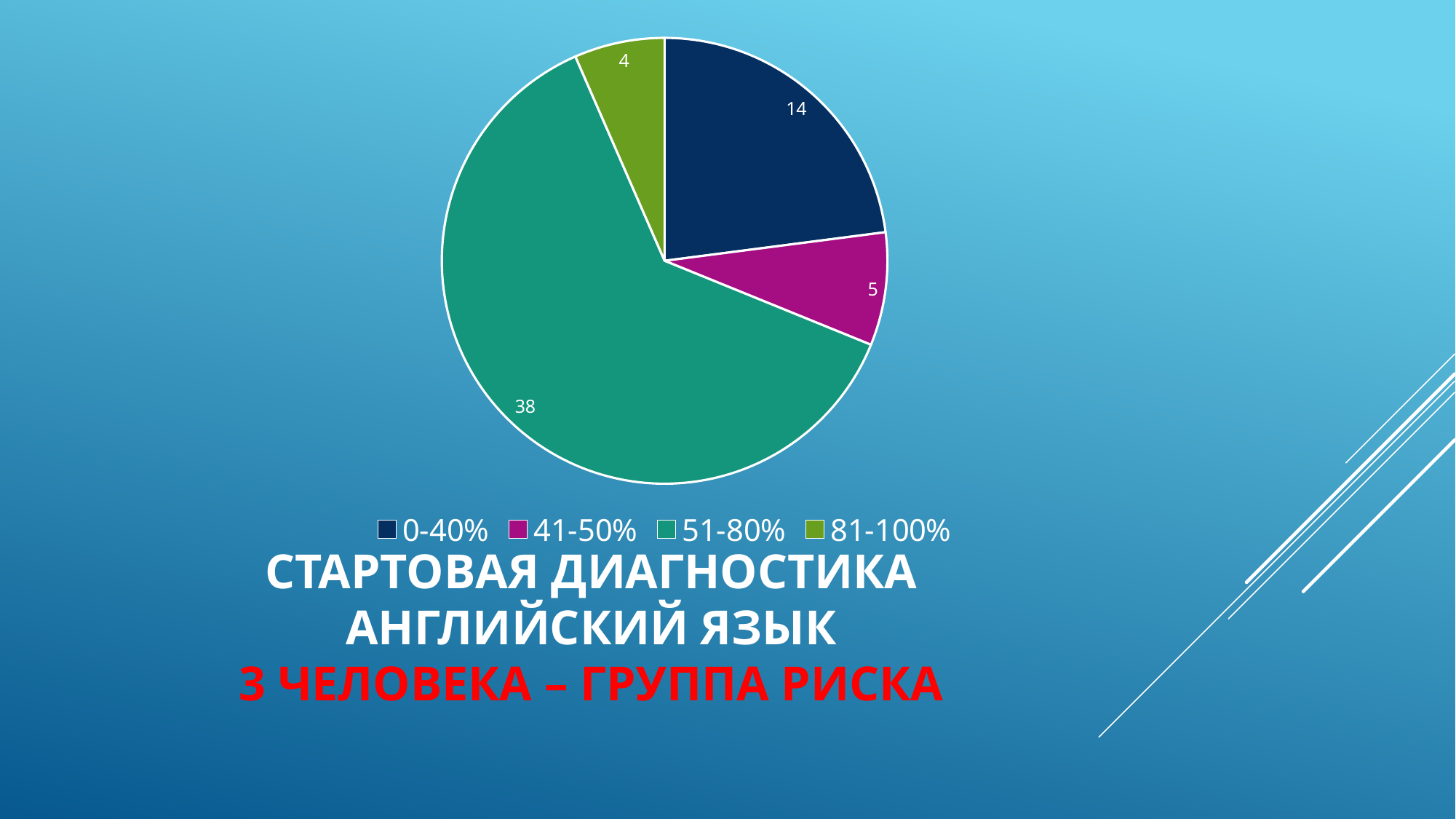
What is the total of all the slices in the pie chart? 61 Which is larger, the value for 0-40% or the value for 41-50%? 0-40% What is the value for the 51-80% slice? 38 Which category has the smallest slice of the pie? 81-100% What type of chart is shown on the slide? Pie chart How many categories does the pie chart have? 4 What is the value for the 41-50% slice? 5 What colour is the 51-80% slice in the pie chart? Teal green What is the difference between the values for 51-80% and 0-40%? 24 Which category has the largest slice of the pie? 51-80% What is the value for the 81-100% slice? 4 What is the value for the 0-40% slice? 14